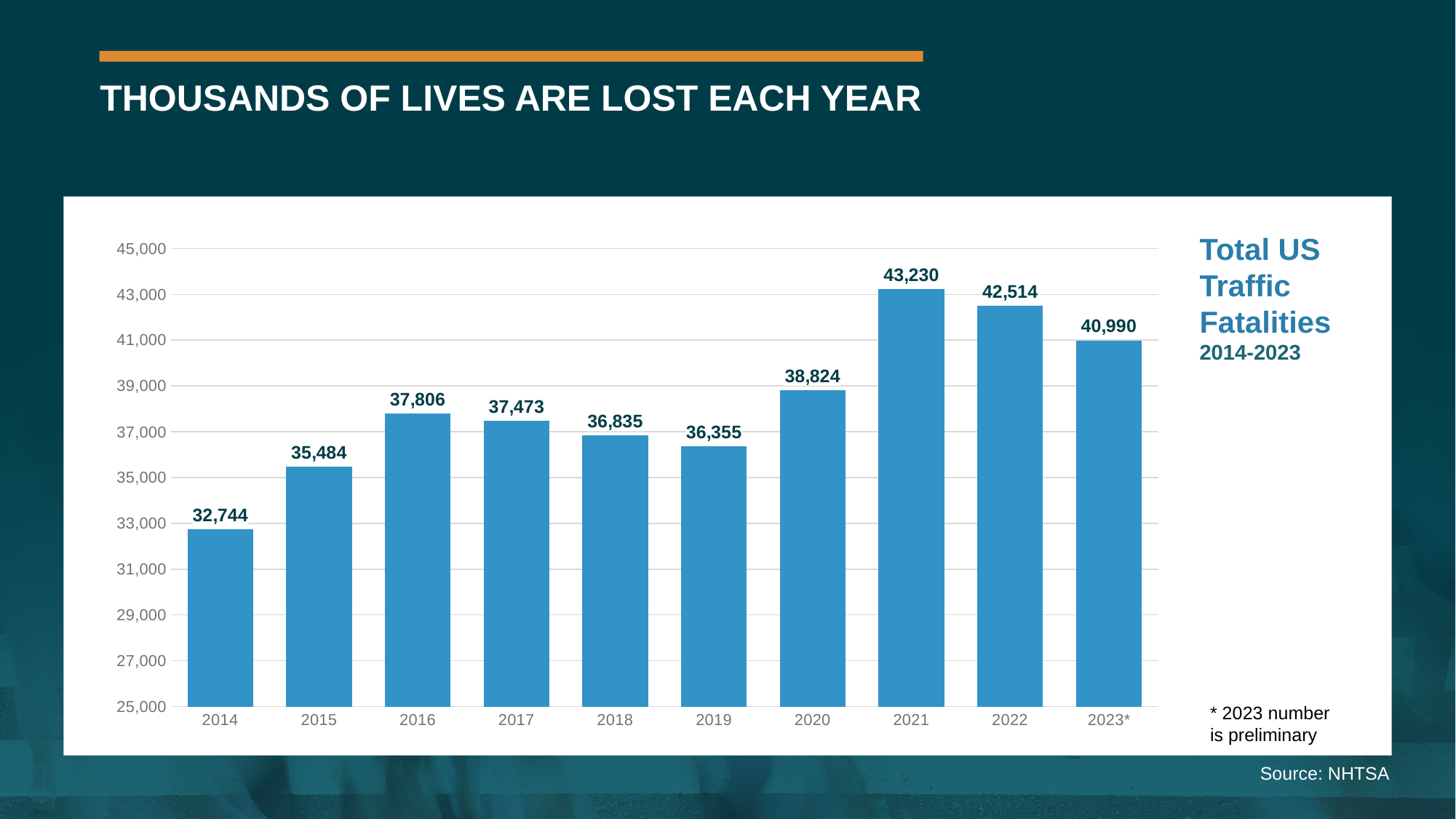
Did traffic fatalities rise or fall from 2019 to 2021? Rise How many years are shown on the chart? 10 Which year had the highest number of traffic fatalities? 2021 What was the total number of US traffic fatalities in 2014? 32,744 Which year had the lowest number of traffic fatalities? 2014 What was the total number of US traffic fatalities in 2021? 43,230 What is the difference between the 2021 and 2022 fatality totals? 716 Which year had more traffic fatalities, 2016 or 2017? 2016 Is the value for 2020 greater or less than 39,000? less What is the source cited for the chart data? NHTSA What is the value shown for 2023*? 40,990 What kind of chart is shown on the slide? Bar chart